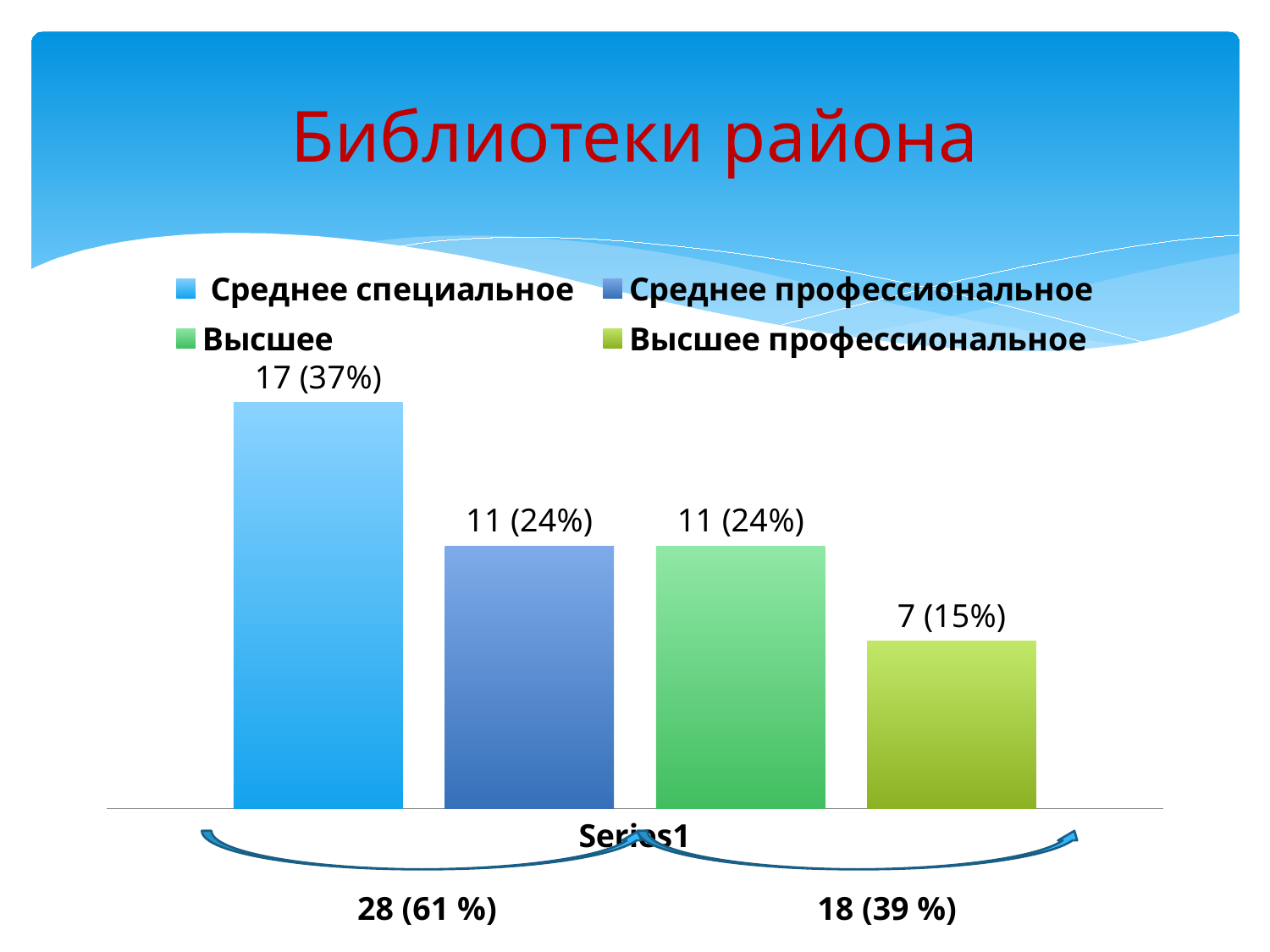
What kind of chart is shown on the slide? Bar chart What value is shown for Среднее специальное? 17 (37%) What is the title of the slide containing the chart? Библиотеки района What total is written under the left bracket below the chart? 28 (61 %) What value is shown for Высшее профессиональное? 7 (15%) What is the difference between the values for Среднее специальное and Высшее профессиональное? 10 Which series has the lowest value? Высшее профессиональное Which series has the highest value? Среднее специальное Which is larger, the value for Среднее специальное or the value for Высшее? Среднее специальное What is the difference between the values for Среднее профессиональное and Высшее профессиональное? 4 How many series does the legend list? 4 What value is shown for Высшее? 11 (24%)